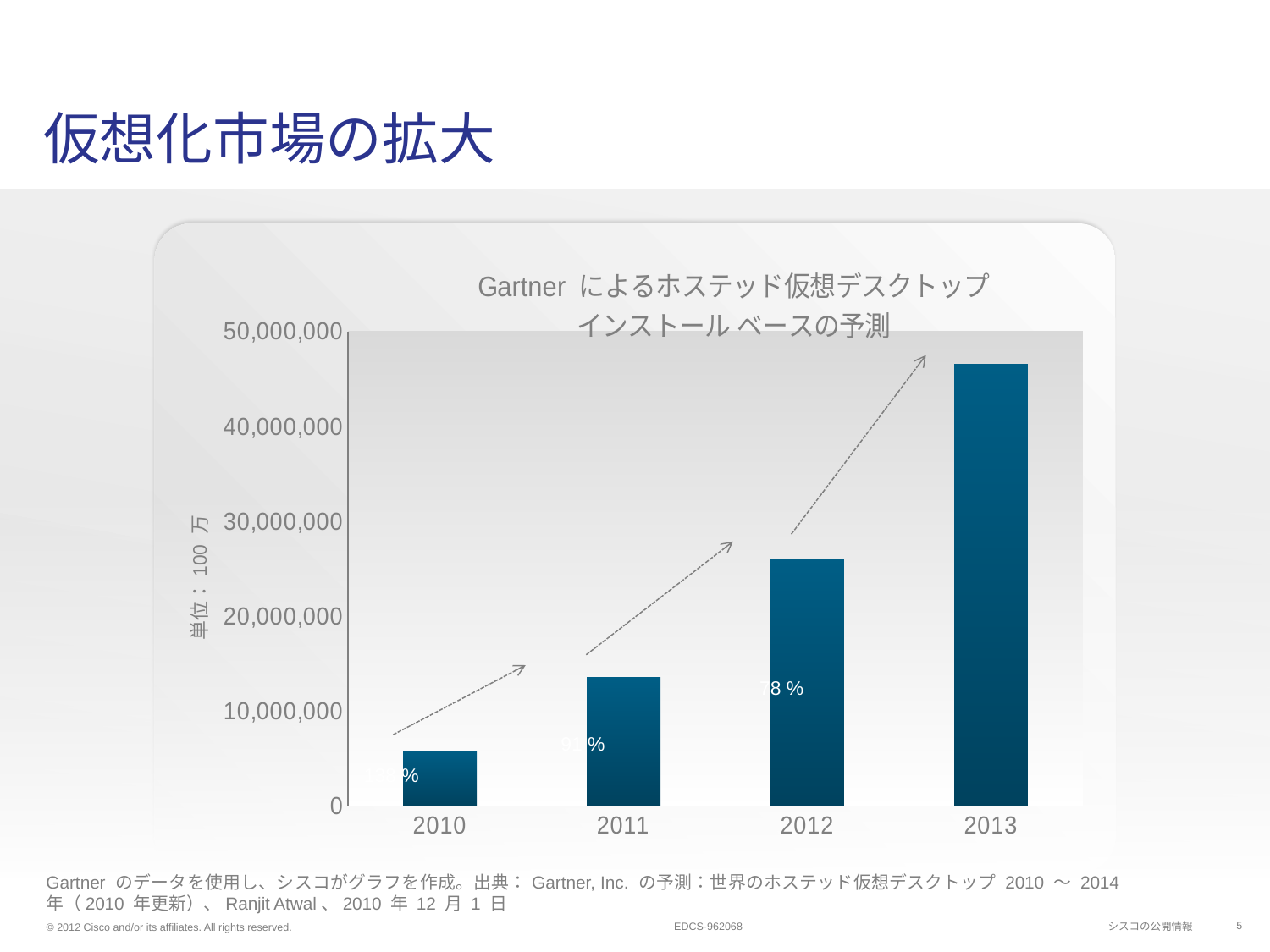
Is the value for 2010 greater or less than 10,000,000? less Which is larger, the value for 2012 or the value for 2011? 2012 What kind of chart is shown on the slide? bar chart What is the highest value shown on the y axis of the chart? 50,000,000 What percentage label is printed on the 2012 bar? 78 % Is the value for 2013 greater or less than 40,000,000? greater Which year has the highest bar in the chart? 2013 Is the value for 2011 greater or less than 20,000,000? less How many years are shown on the x axis of the chart? 4 Which year has the lowest bar in the chart? 2010 Do the values rise or fall from 2010 to 2013? rise